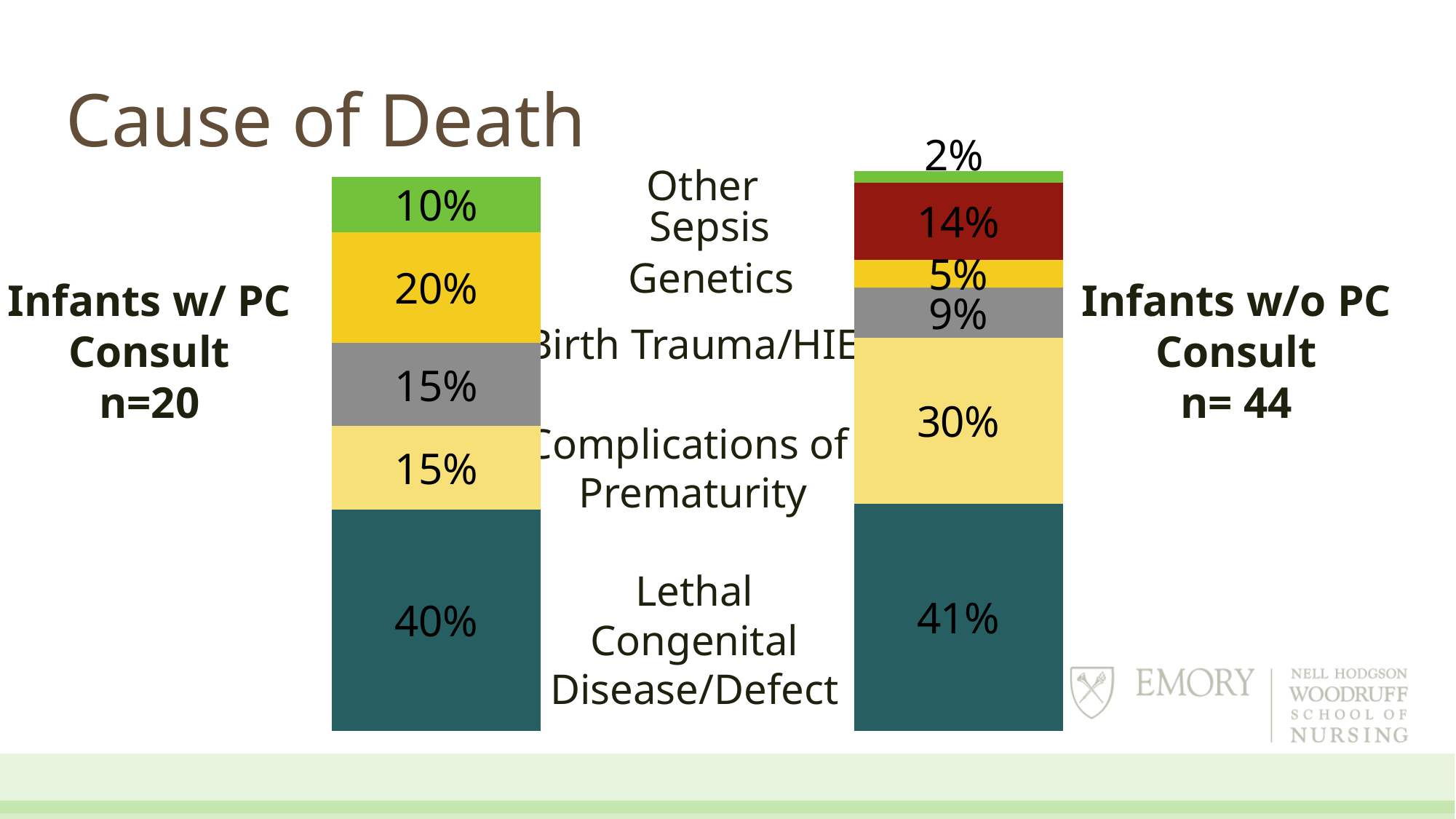
Which cause of death has the smallest share in the Infants w/o PC Consult bar? Other What percentage of deaths among Infants w/o PC Consult were due to Lethal Congenital Disease/Defect? 41% What kind of chart is shown on the slide? stacked bar chart Which group has the larger share of deaths due to Genetics, Infants w/ PC Consult or Infants w/o PC Consult? Infants w/ PC Consult What percentage of deaths among Infants w/ PC Consult were due to Genetics? 20% What is the title of the slide? Cause of Death What percentage of deaths among Infants w/o PC Consult were due to Sepsis? 14% What percentage of deaths among Infants w/ PC Consult were due to Lethal Congenital Disease/Defect? 40% How many infants are in the Infants w/o PC Consult group? 44 Which cause of death has the largest share in the Infants w/o PC Consult bar? Lethal Congenital Disease/Defect What percentage of deaths among Infants w/o PC Consult were due to Complications of Prematurity? 30% What is the difference between the Complications of Prematurity share for Infants w/o PC Consult and for Infants w/ PC Consult? 15%